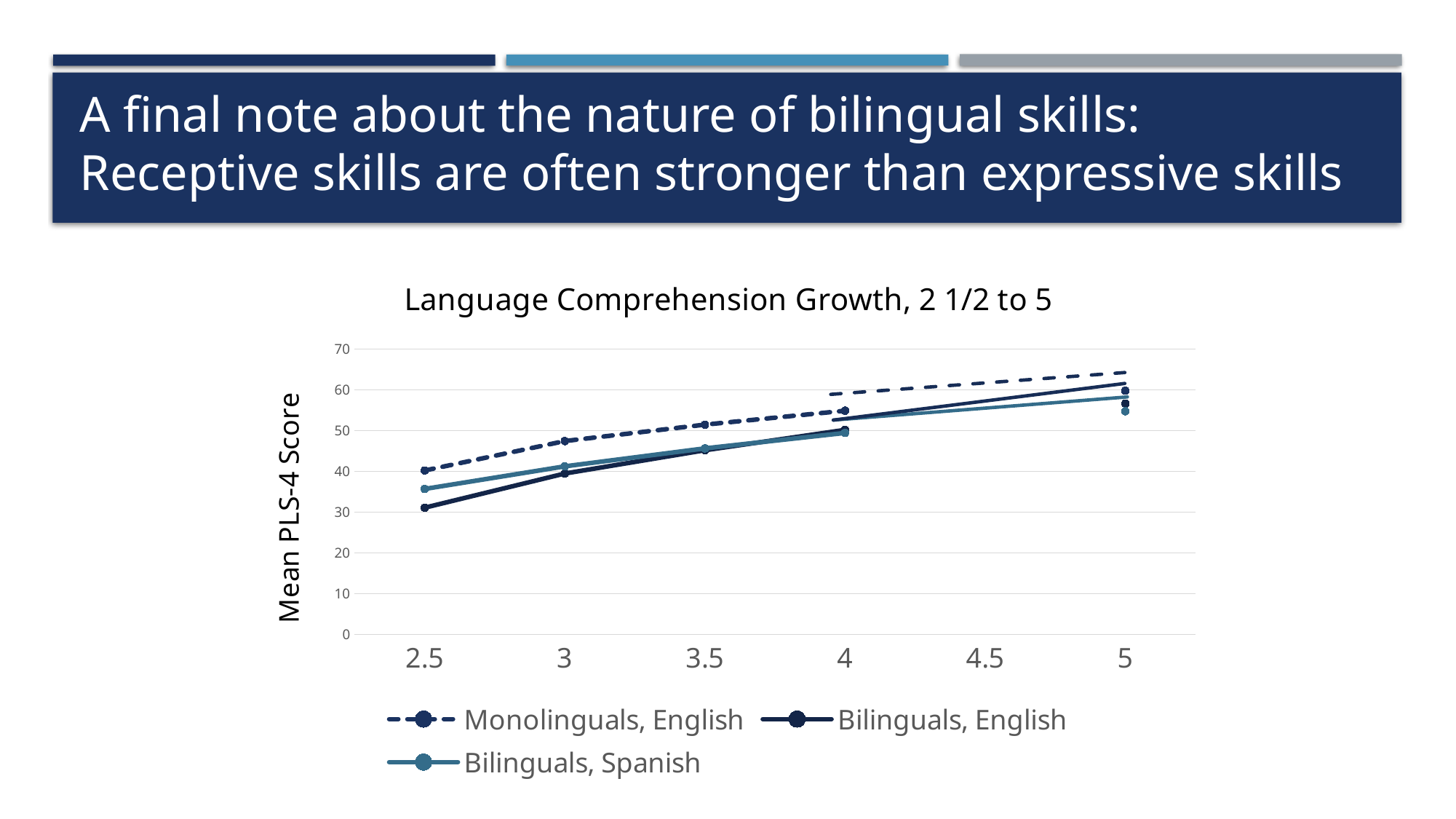
How many age points are labelled on the x axis? 6 Which series has the highest score at age 3? Monolinguals, English How many series does the legend list? 3 At age 3, which is larger: the score for Monolinguals, English or for Bilinguals, English? Monolinguals, English Is the value for Monolinguals, English at age 3 greater or less than 40? greater Is the value for Bilinguals, Spanish at age 2.5 greater or less than 40? less Which series has the highest score at age 2.5? Monolinguals, English Is the value for Bilinguals, English at age 2.5 greater or less than 40? less Which series has the lowest score at age 2.5? Bilinguals, English Do the scores rise or fall as age increases from 2.5 to 5? rise What is the title of the chart? Language Comprehension Growth, 2 1/2 to 5 What kind of chart is shown on the slide? line chart